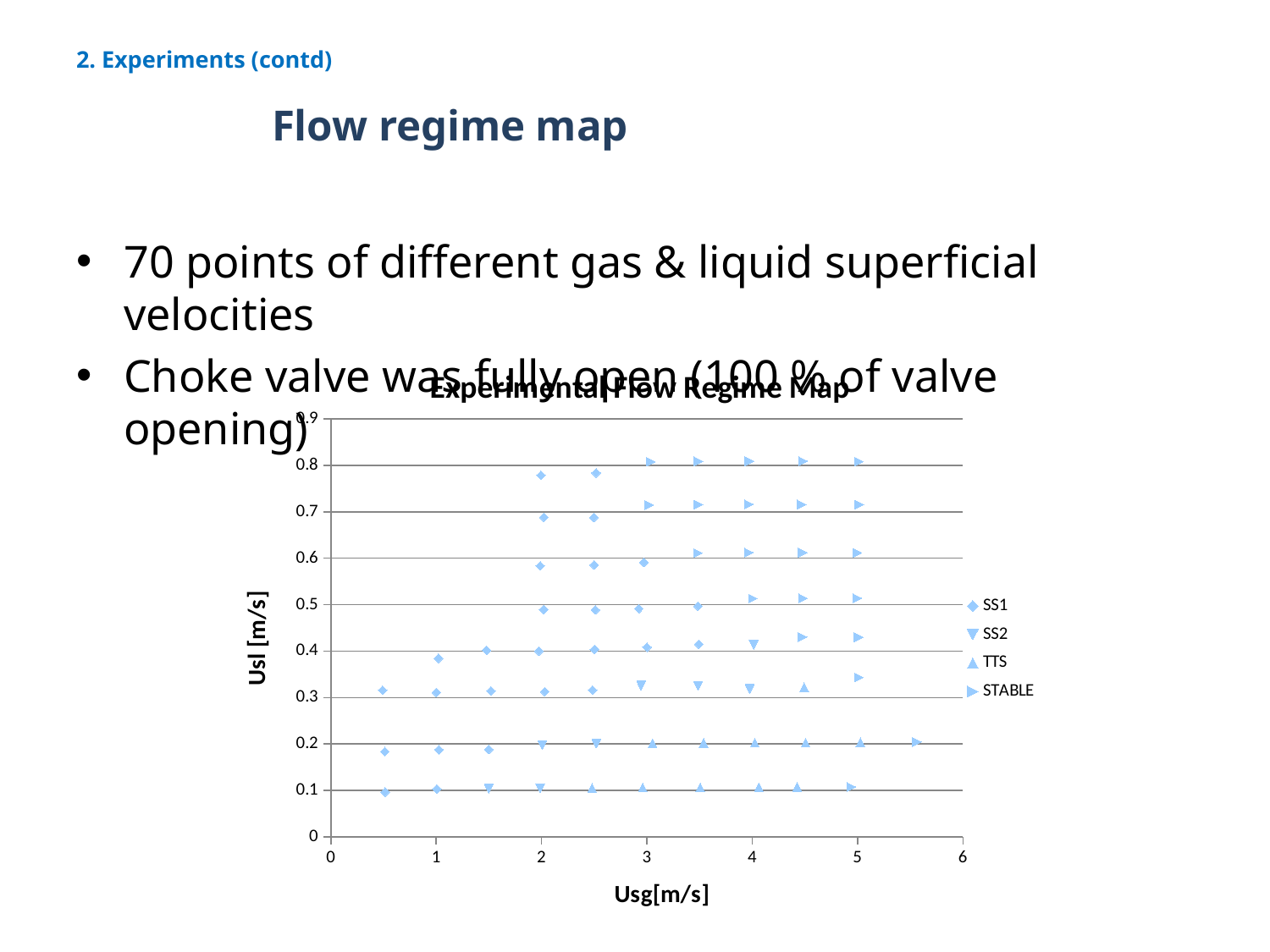
How many series does the legend of the Experimental Flow Regime Map list? 4 What kind of chart is shown on the slide? scatter chart Is the largest Usg value plotted on the chart greater or less than 5? greater What are the four series named in the chart legend? SS1, SS2, TTS, STABLE Is the smallest Usl value plotted on the chart greater or less than 0.2? less Is the largest Usl value plotted on the chart greater or less than 0.9? less What is the title of the chart on the slide? Experimental Flow Regime Map